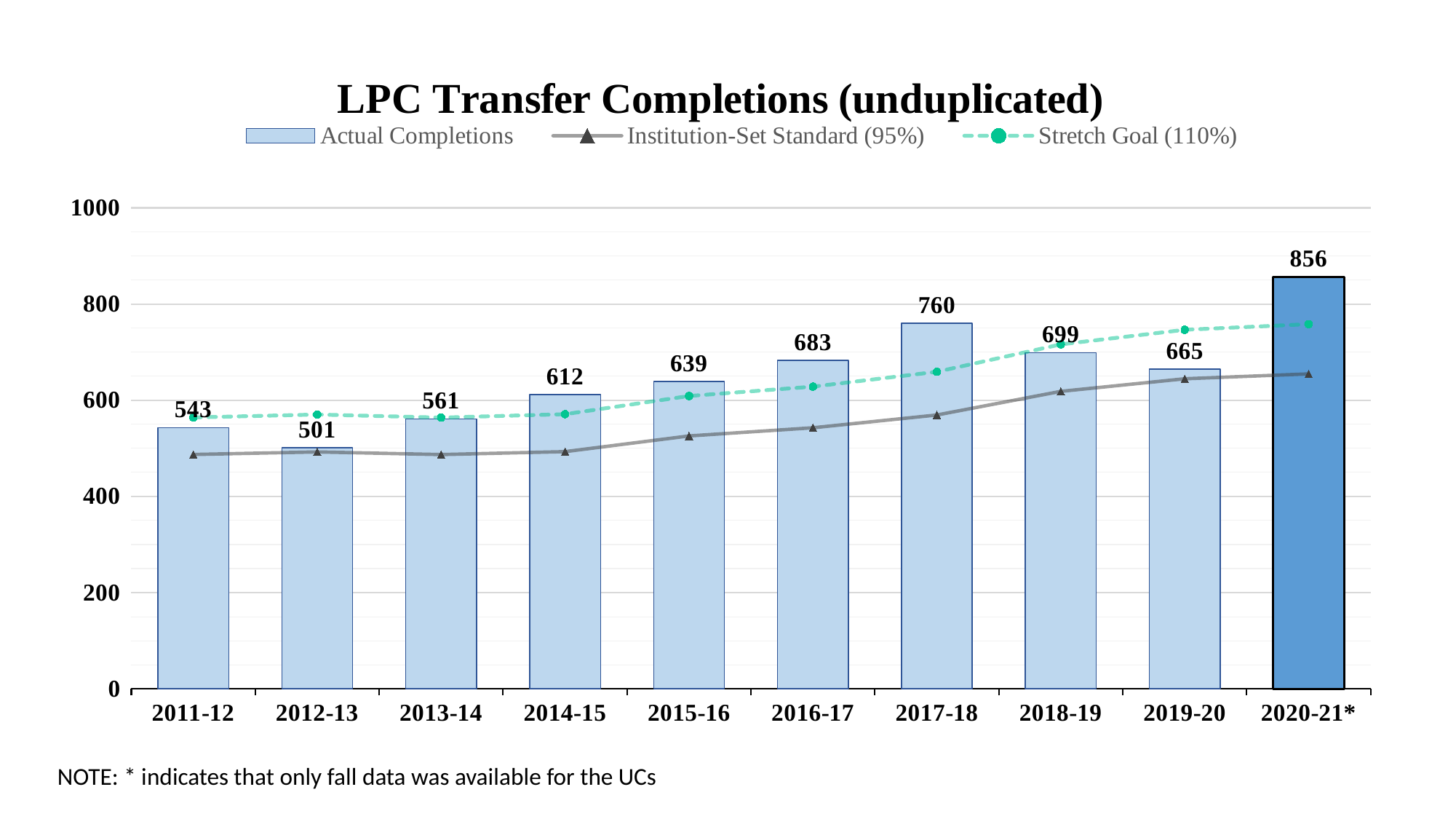
Is the Stretch Goal (110%) value for 2020-21* greater or less than 800? less How many series does the legend list? 3 What is the difference in Actual Completions between 2020-21* and 2019-20? 191 Which year has the highest Actual Completions? 2020-21* How many years are shown on the x axis? 10 Which year has more Actual Completions, 2014-15 or 2015-16? 2015-16 What is the value of Actual Completions for 2012-13? 501 What type of chart is used for Actual Completions? Bar chart What is the title of the chart? LPC Transfer Completions (unduplicated) Which year has the lowest Actual Completions? 2012-13 What is the value of Actual Completions for 2017-18? 760 Is the Institution-Set Standard (95%) value for 2011-12 greater or less than 400? greater